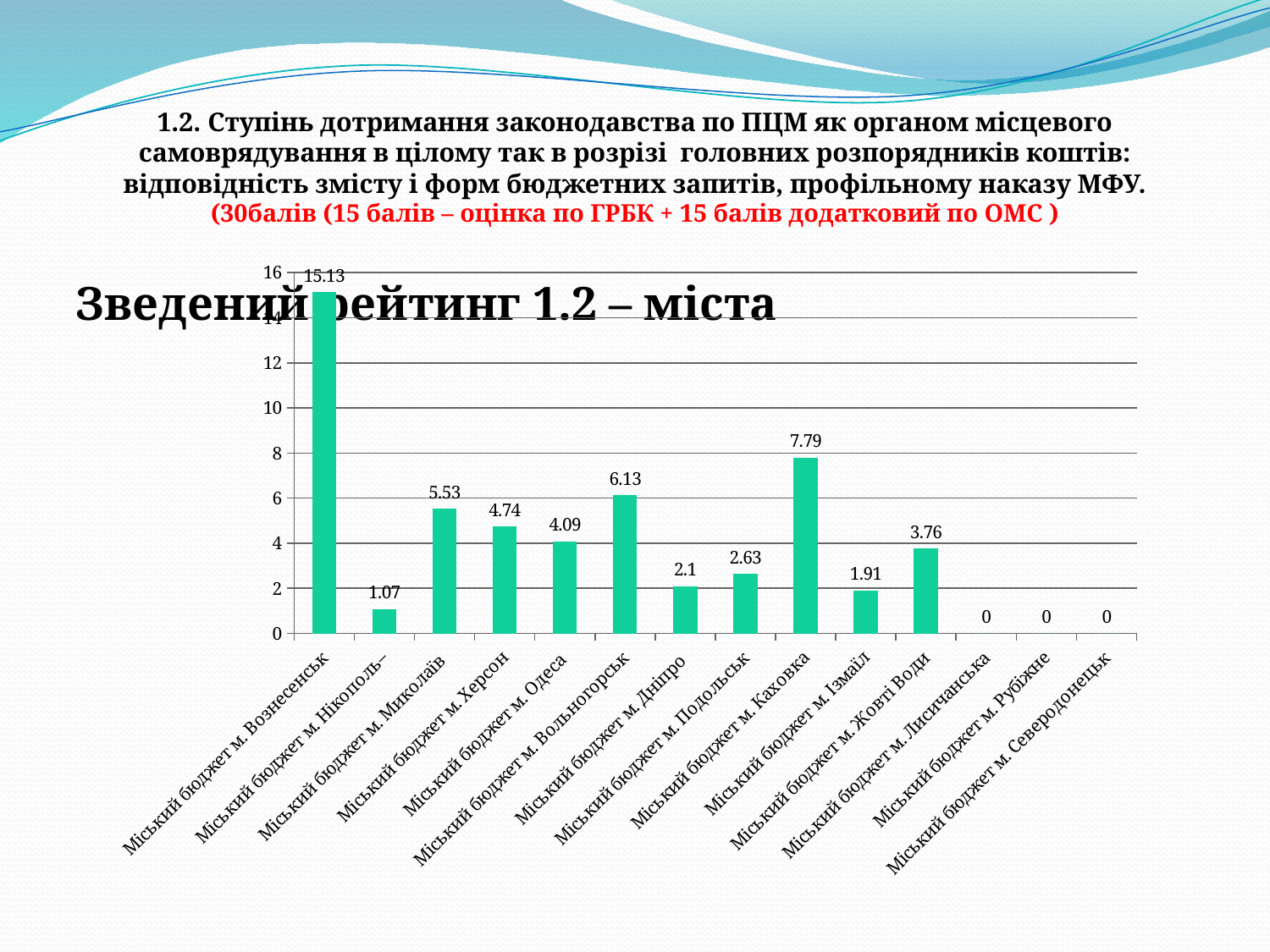
How many city budgets have a value of 0? 3 Is the value for Міський бюджет м. Каховка greater or less than 8? less What is the difference between the values for Міський бюджет м. Вольногорськ and Міський бюджет м. Миколаїв? 0.6 Which city budget has the highest value on the chart? Міський бюджет м. Вознесенськ What is the value for Міський бюджет м. Вознесенськ? 15.13 What is the value for Міський бюджет м. Каховка? 7.79 What is the value for Міський бюджет м. Жовті Води? 3.76 Which is larger, the value for Міський бюджет м. Херсон or for Міський бюджет м. Одеса? Міський бюджет м. Херсон What is the value for Міський бюджет м. Дніпро? 2.1 How many city budgets are shown on the chart? 14 What kind of chart is shown on the slide? Bar chart What is the value for Міський бюджет м. Нікополь? 1.07